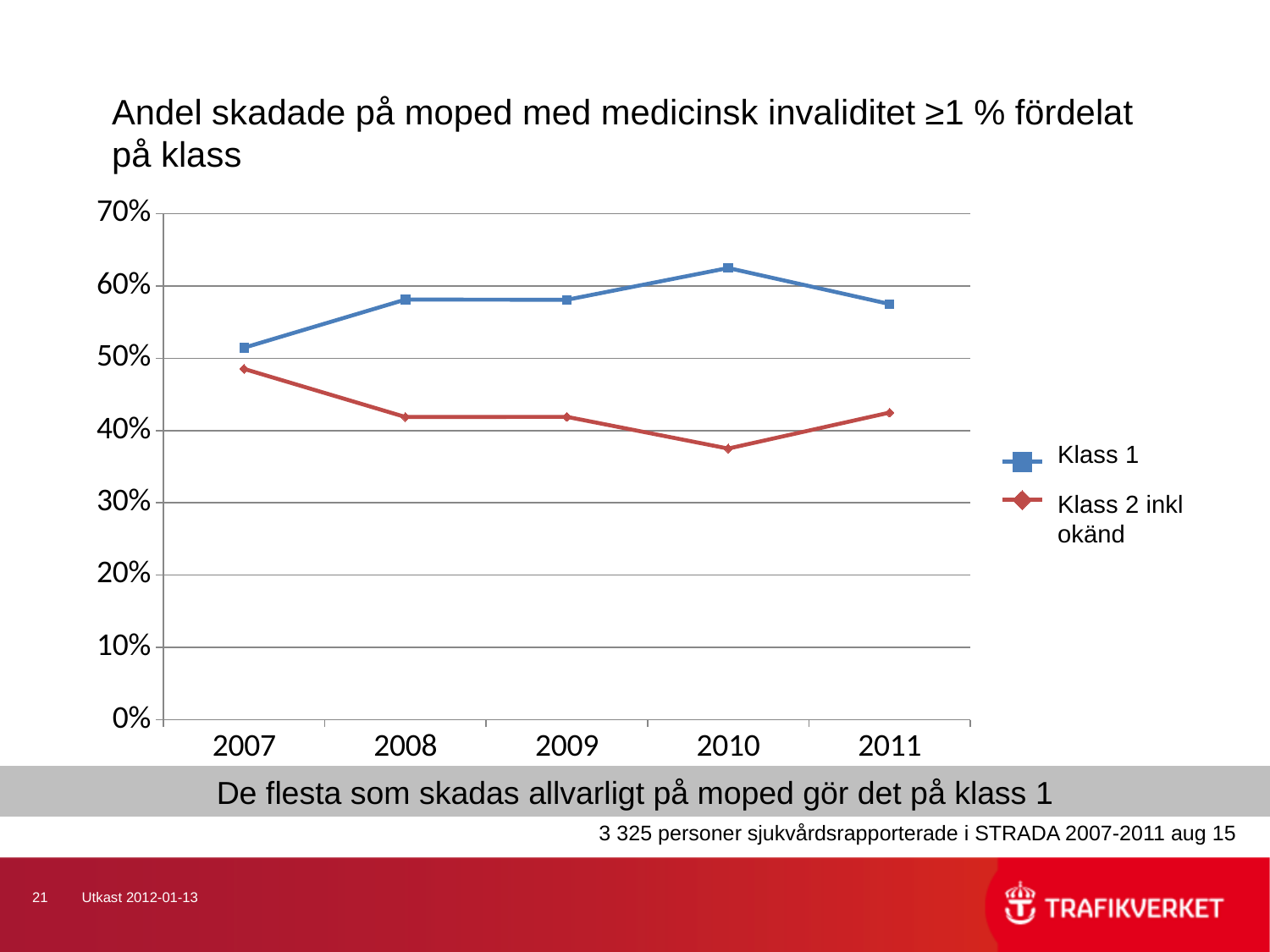
In which year does the Klass 1 series have its lowest value? 2007 How many years are shown on the x axis? 5 Is the value for Klass 1 in 2010 greater or less than 60%? greater Which series is drawn in blue with square markers? Klass 1 Is the value for Klass 1 in 2007 greater or less than 50%? greater Which series has the higher value in 2011, Klass 1 or Klass 2 inkl okänd? Klass 1 How many series does the legend list? 2 Is the value for Klass 2 inkl okänd in 2010 greater or less than 40%? less Does the Klass 2 inkl okänd series rise or fall from 2007 to 2008? fall In which year does the Klass 2 inkl okänd series reach its lowest value? 2010 In which year does the Klass 1 series reach its highest value? 2010 What kind of chart is shown on the slide? line chart